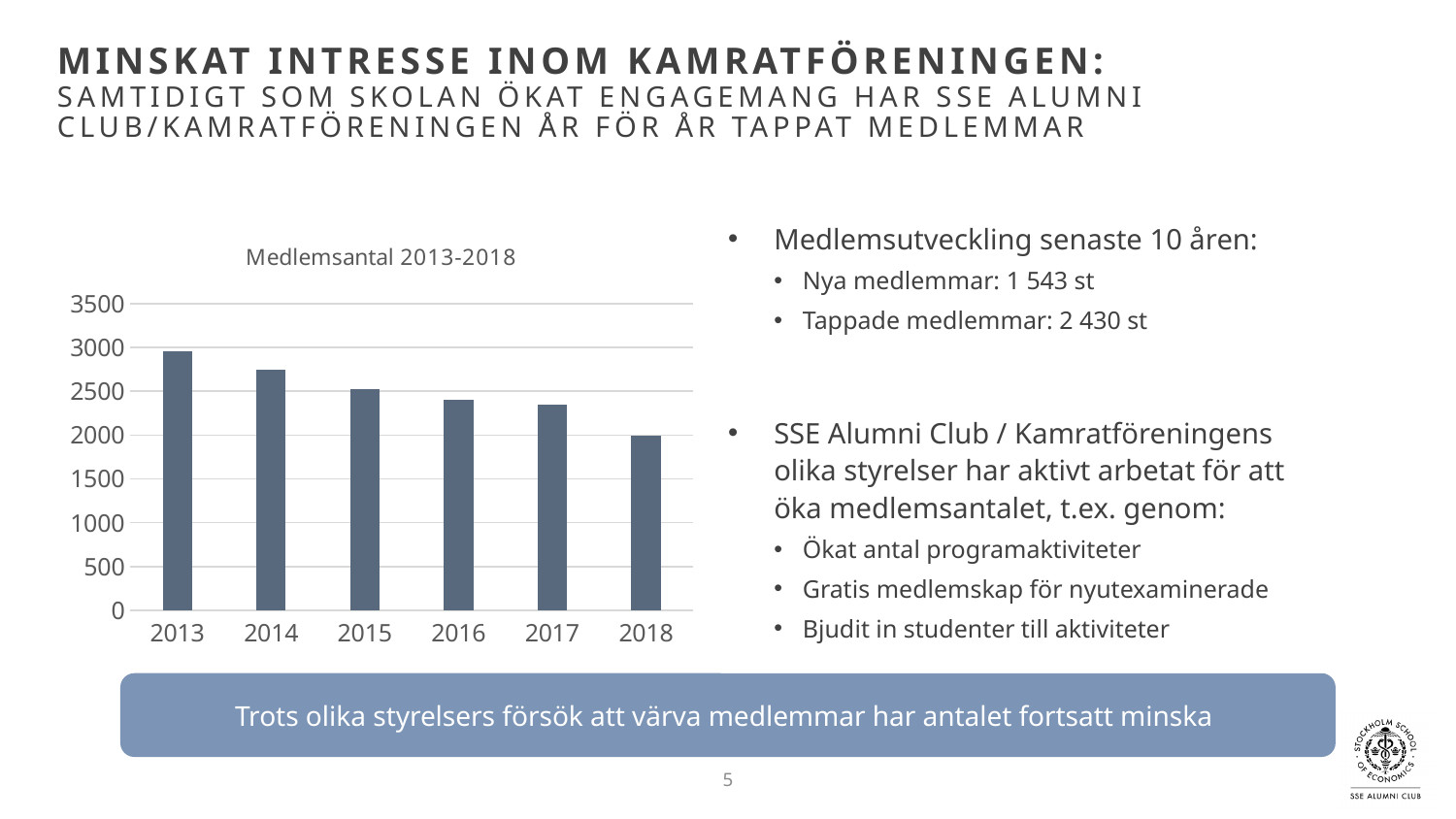
How many years are shown on the x axis of the chart? 6 What kind of chart is shown on the slide? bar chart What is the title of the chart? Medlemsantal 2013-2018 Which year has the lowest value in the chart? 2018 Is the value for 2013 greater or less than 2500? greater Which year has the larger value, 2013 or 2018? 2013 Do the values rise or fall from 2013 to 2018? fall Is the value for 2017 greater or less than 2500? less Is the value for 2014 greater or less than 2500? greater Which year has the larger value, 2014 or 2017? 2014 Which year has the highest value in the chart? 2013